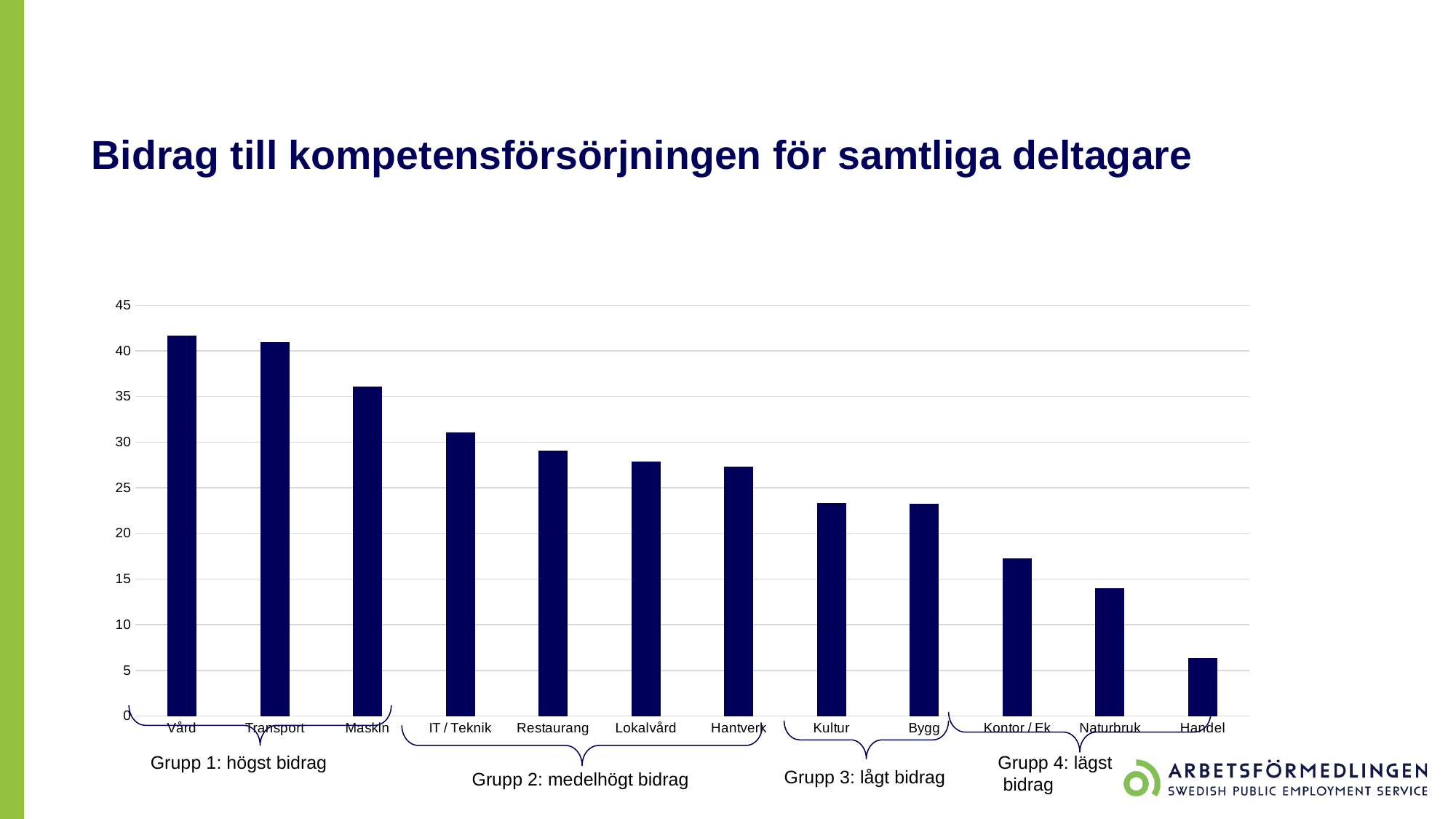
Is the value for Restaurang greater or less than 30? less Which category has the lowest value in the chart? Handel Is the value for Vård greater or less than 40? greater How many categories are plotted on the x axis of the chart? 12 Is the value for Maskin greater or less than 35? greater Which has the larger value, Maskin or IT / Teknik? Maskin What is the title of the slide containing the chart? Bidrag till kompetensförsörjningen för samtliga deltagare Do the values rise or fall moving from left to right along the x axis? fall What kind of chart is shown on the slide? bar chart Which has the larger value, Naturbruk or Handel? Naturbruk